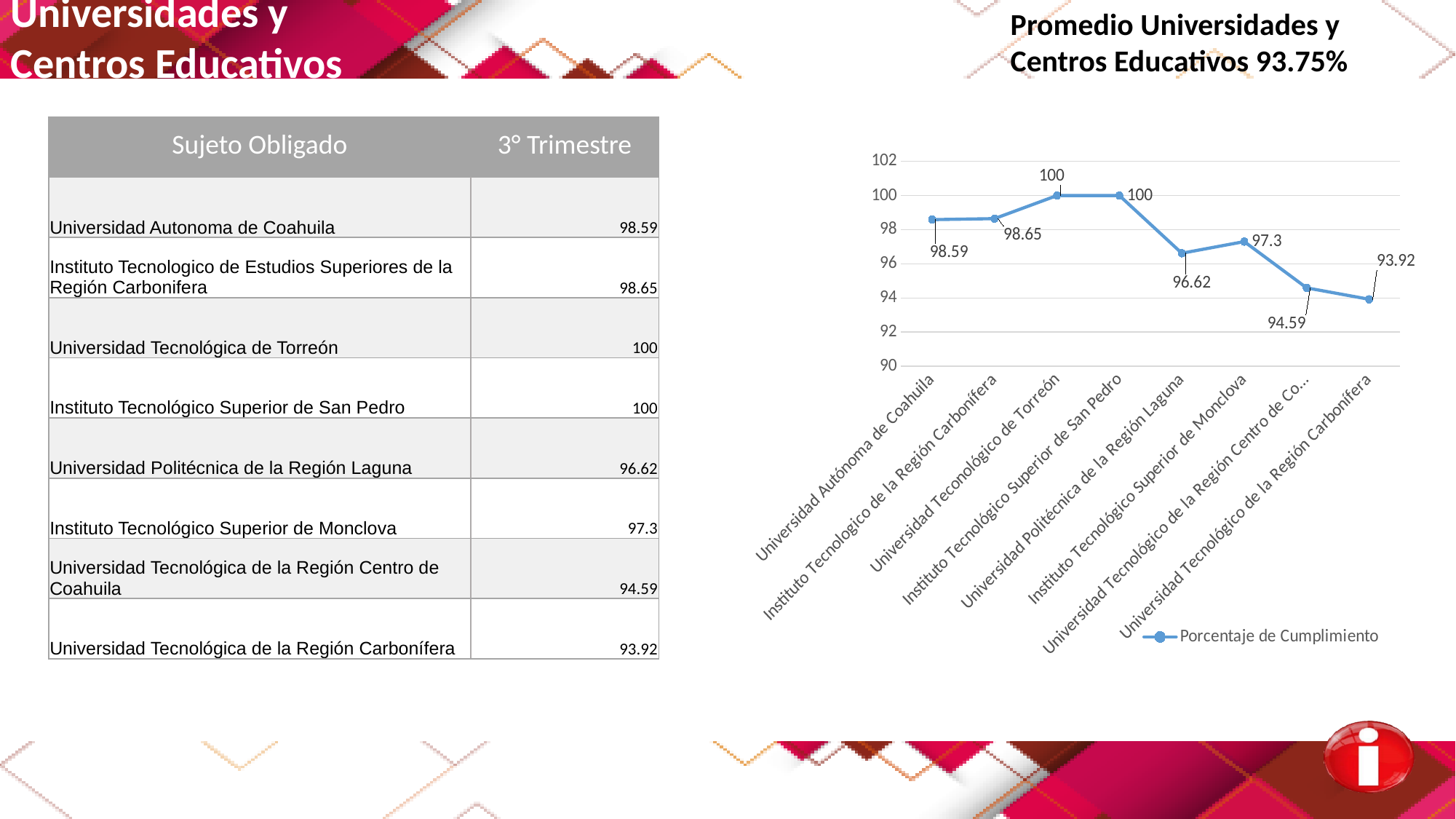
What is the difference between the values for Instituto Tecnológico Superior de Monclova and Universidad Politécnica de la Región Laguna? 0.68 Is the value for Instituto Tecnológico Superior de San Pedro greater or less than 98? greater What is the value for Instituto Tecnológico Superior de Monclova in the chart? 97.3 What type of chart is shown on the slide? line chart What is the value for Universidad Tecnológico de Torreón in the chart? 100 Which is larger: the value for Universidad Autónoma de Coahuila or the value for Universidad Tecnológica de la Región Carbonífera? Universidad Autónoma de Coahuila Which category has the lowest value in the chart? Universidad Tecnológica de la Región Carbonífera How many data points are plotted in the chart? 8 What is the name of the series shown in the chart legend? Porcentaje de Cumplimiento How many series does the chart legend list? 1 What is the value for Universidad Autónoma de Coahuila in the chart? 98.59 What is the value for Universidad Politécnica de la Región Laguna in the chart? 96.62